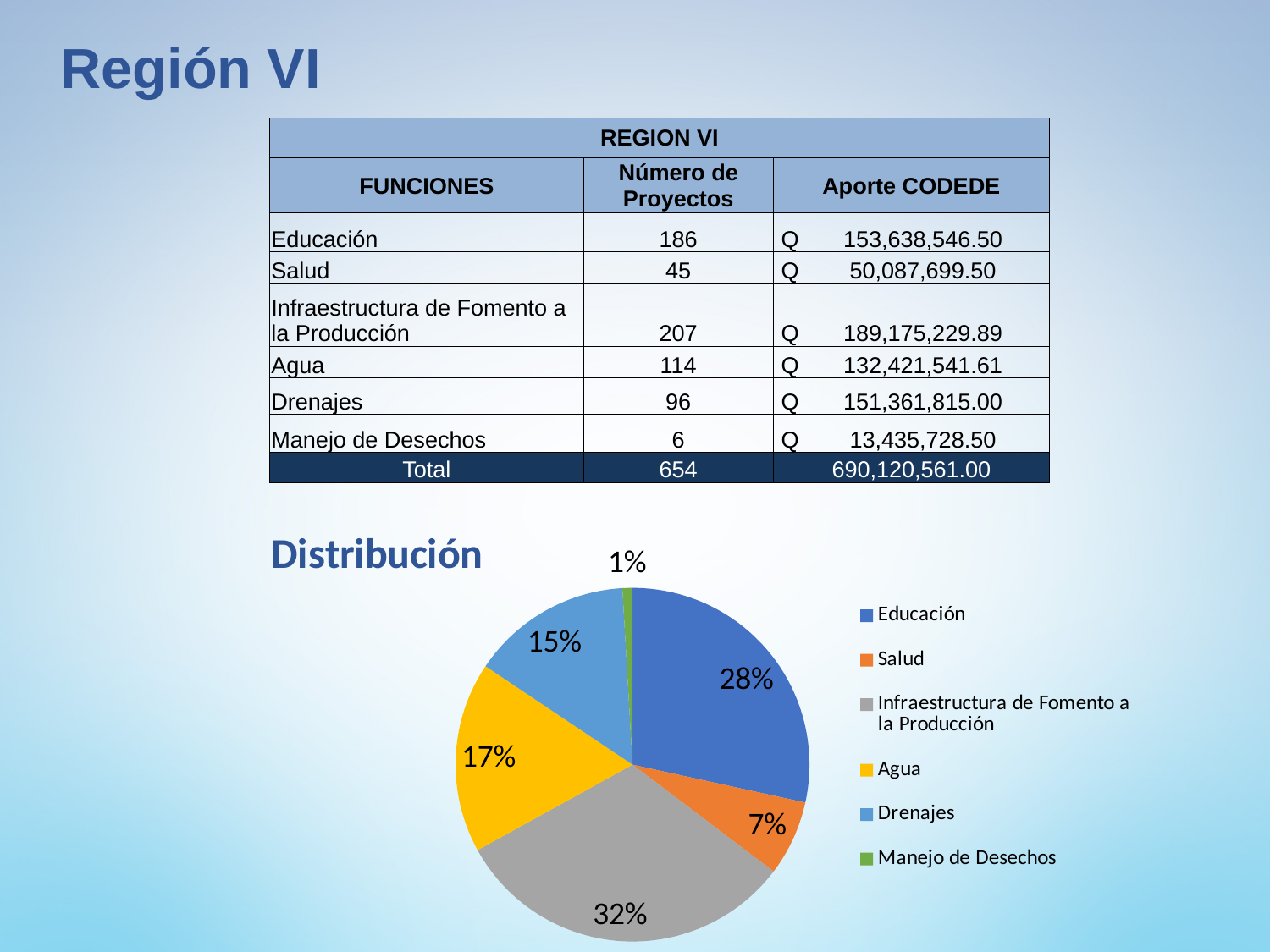
In the "Distribución" pie chart, what is the difference in percentage points between the Infraestructura de Fomento a la Producción slice and the Educación slice? 4 In the "Distribución" pie chart, what share does Infraestructura de Fomento a la Producción have? 32% In the "Distribución" pie chart, what share does Drenajes have? 15% Which category has the smallest slice in the "Distribución" pie chart? Manejo de Desechos In the "Distribución" pie chart, what share does Manejo de Desechos have? 1% What kind of chart is shown under the title "Distribución"? pie chart How many categories does the legend of the "Distribución" pie chart list? 6 In the "Distribución" pie chart, which slice is larger, Agua or Drenajes? Agua Which category has the largest slice in the "Distribución" pie chart? Infraestructura de Fomento a la Producción